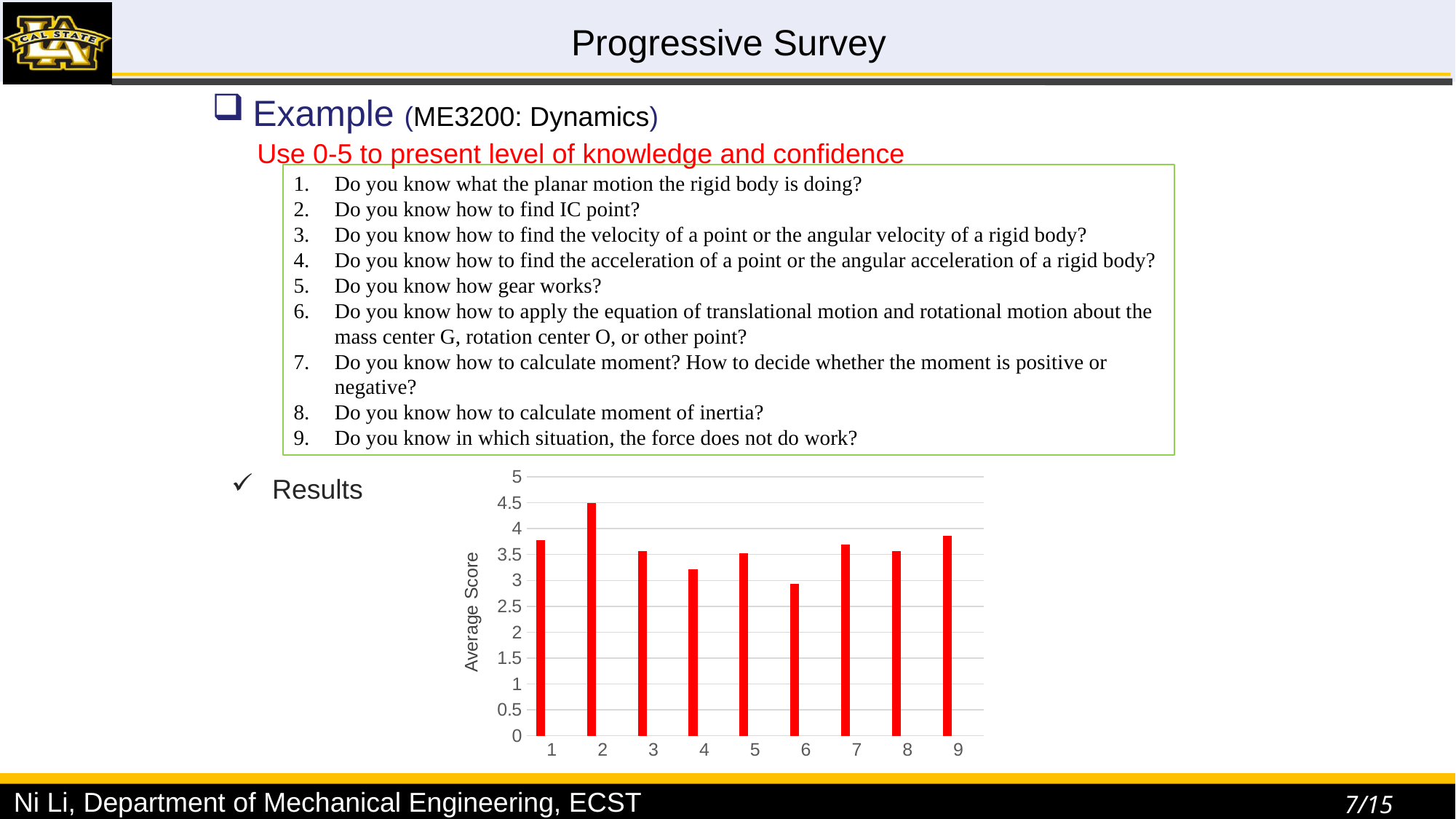
Is the average score for question 4 greater or less than 3.5? less What is the maximum value shown on the vertical axis of the bar chart? 5 Is the average score for question 9 greater or less than 3.5? greater Which question number has the lowest average score in the bar chart? 6 Which question number has the highest average score in the bar chart? 2 Which has a higher average score, question 4 or question 9? question 9 Which has a higher average score, question 2 or question 6? question 2 What kind of chart is shown under "Results" on the slide? bar chart How many categories (questions) are plotted on the x axis of the bar chart? 9 Is the average score for question 2 greater or less than 4? greater What is the label on the vertical axis of the bar chart? Average Score